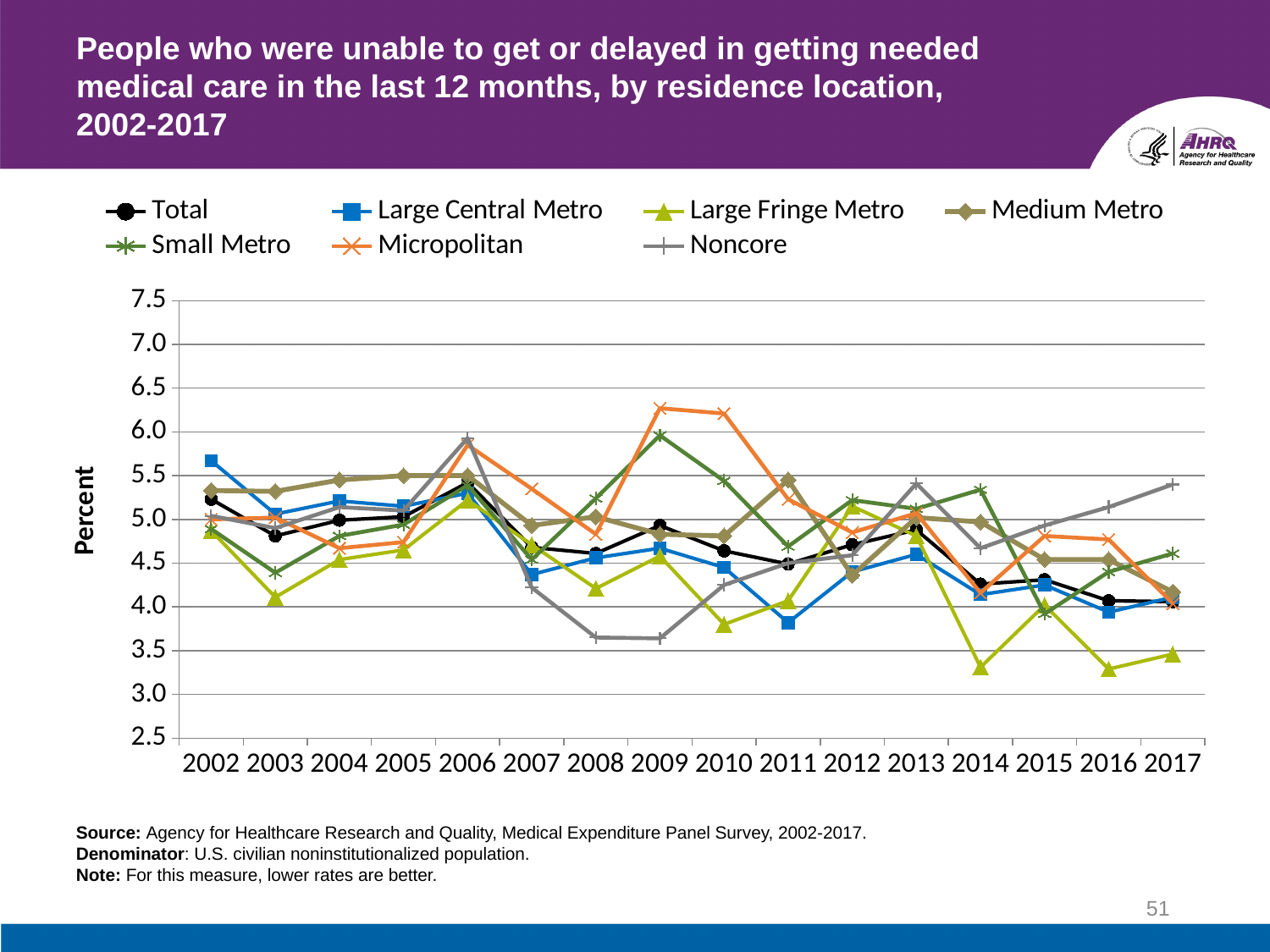
Which residence location has the highest value in 2009? Micropolitan What is the label on the y axis? Percent What kind of chart is shown on the slide? Line chart Is the value for Large Central Metro in 2002 greater or less than 5.5? greater Is the value for Large Fringe Metro in 2014 greater or less than 3.5? less In 2017, which is larger: the value for Noncore or the value for Large Central Metro? Noncore How many series does the legend list? 7 Does the Large Fringe Metro line rise or fall overall from 2002 to 2017? Fall Is the value for Micropolitan in 2009 greater or less than 6.0? greater Which residence location has the lowest value in 2014? Large Fringe Metro How many years are plotted along the x axis? 16